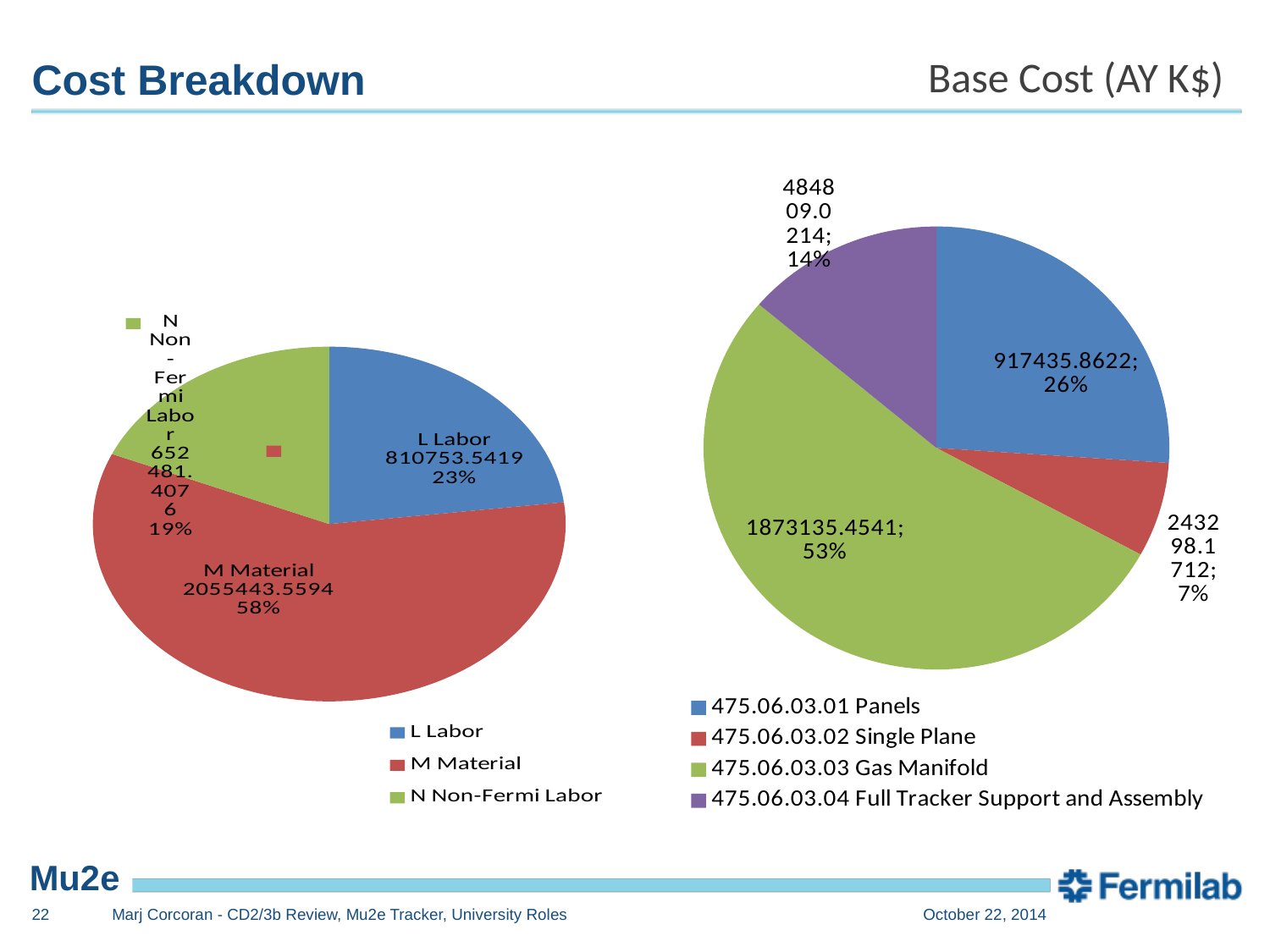
On the left pie chart, what percentage share does L Labor have? 23% On the right pie chart, how many categories does the legend list? 4 On the right pie chart, which is larger: the share for 475.06.03.01 Panels or the share for 475.06.03.04 Full Tracker Support and Assembly? 475.06.03.01 Panels On the right pie chart, what is the value shown for 475.06.03.03 Gas Manifold? 1873135.4541 On the left pie chart, what is the value shown for M Material? 2055443.5594 On the right pie chart, what percentage share does 475.06.03.01 Panels have? 26% On the left pie chart, how many categories are shown? 3 On the right pie chart, which category has the largest slice? 475.06.03.03 Gas Manifold What type of chart is shown on the left of the slide? Pie chart On the right pie chart, which category has the smallest slice? 475.06.03.02 Single Plane On the left pie chart, which category has the largest slice? M Material On the left pie chart, which category has the smallest slice? N Non-Fermi Labor